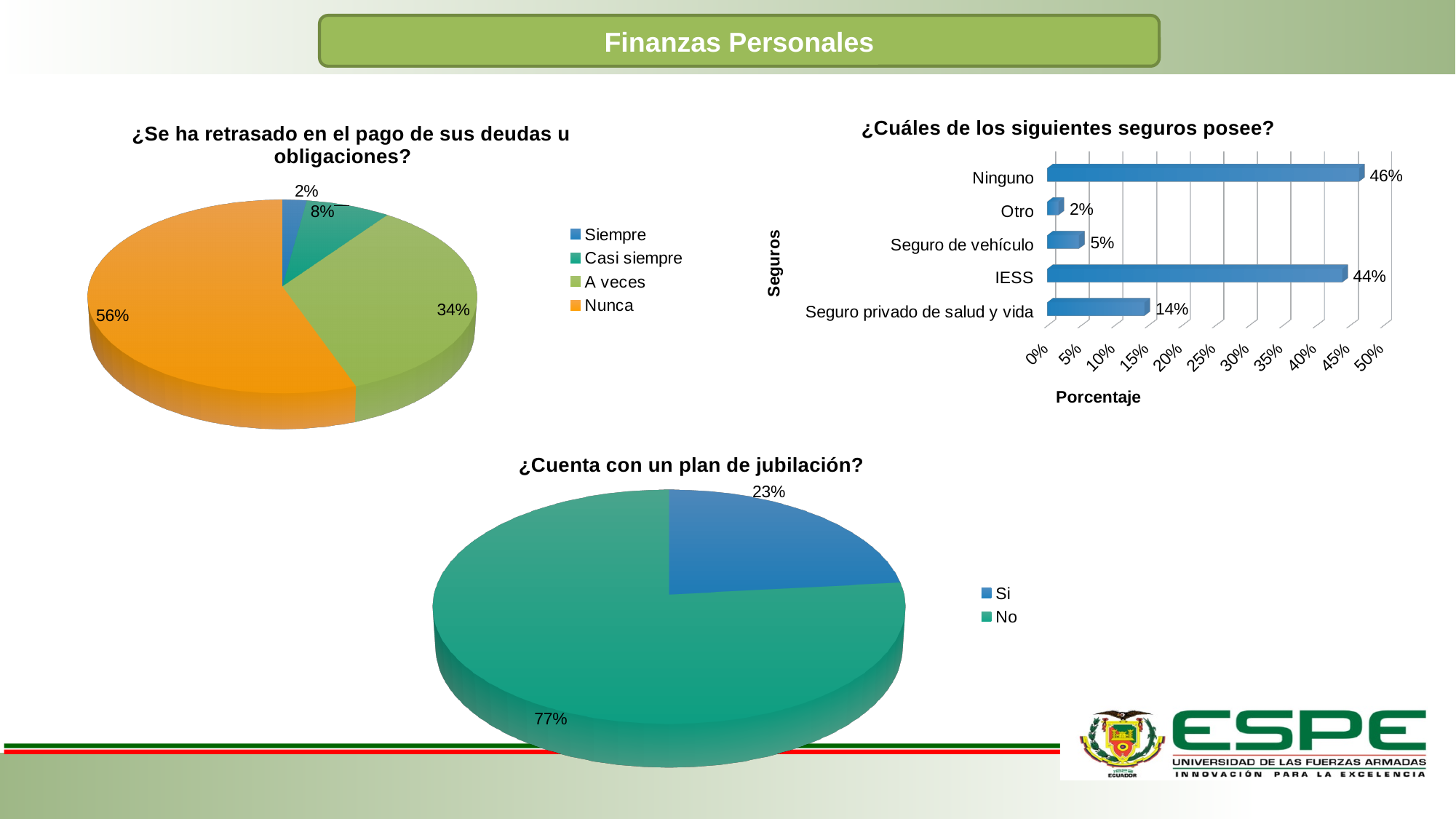
In the chart '¿Se ha retrasado en el pago de sus deudas u obligaciones?', what is the difference between the 'A veces' and 'Casi siempre' shares? 26% What is the label of the horizontal axis in the chart '¿Cuáles de los siguientes seguros posee?'? Porcentaje In the chart '¿Cuenta con un plan de jubilación?', what percentage answered 'Si'? 23% In the chart '¿Se ha retrasado en el pago de sus deudas u obligaciones?', what percentage is shown for 'Nunca'? 56% How many categories does the legend of the chart '¿Se ha retrasado en el pago de sus deudas u obligaciones?' list? 4 In the chart '¿Cuáles de los siguientes seguros posee?', which category has the lowest value? Otro In the chart '¿Cuáles de los siguientes seguros posee?', which category has the highest value? Ninguno In the chart '¿Se ha retrasado en el pago de sus deudas u obligaciones?', which category has the smallest share? Siempre In the chart '¿Cuenta con un plan de jubilación?', which is larger, 'Si' or 'No'? No In the chart '¿Cuáles de los siguientes seguros posee?', what is the value for 'IESS'? 44% What kind of chart is '¿Cuáles de los siguientes seguros posee?'? Bar chart In the chart '¿Cuáles de los siguientes seguros posee?', what is the difference between 'Seguro privado de salud y vida' and 'Seguro de vehículo'? 9%